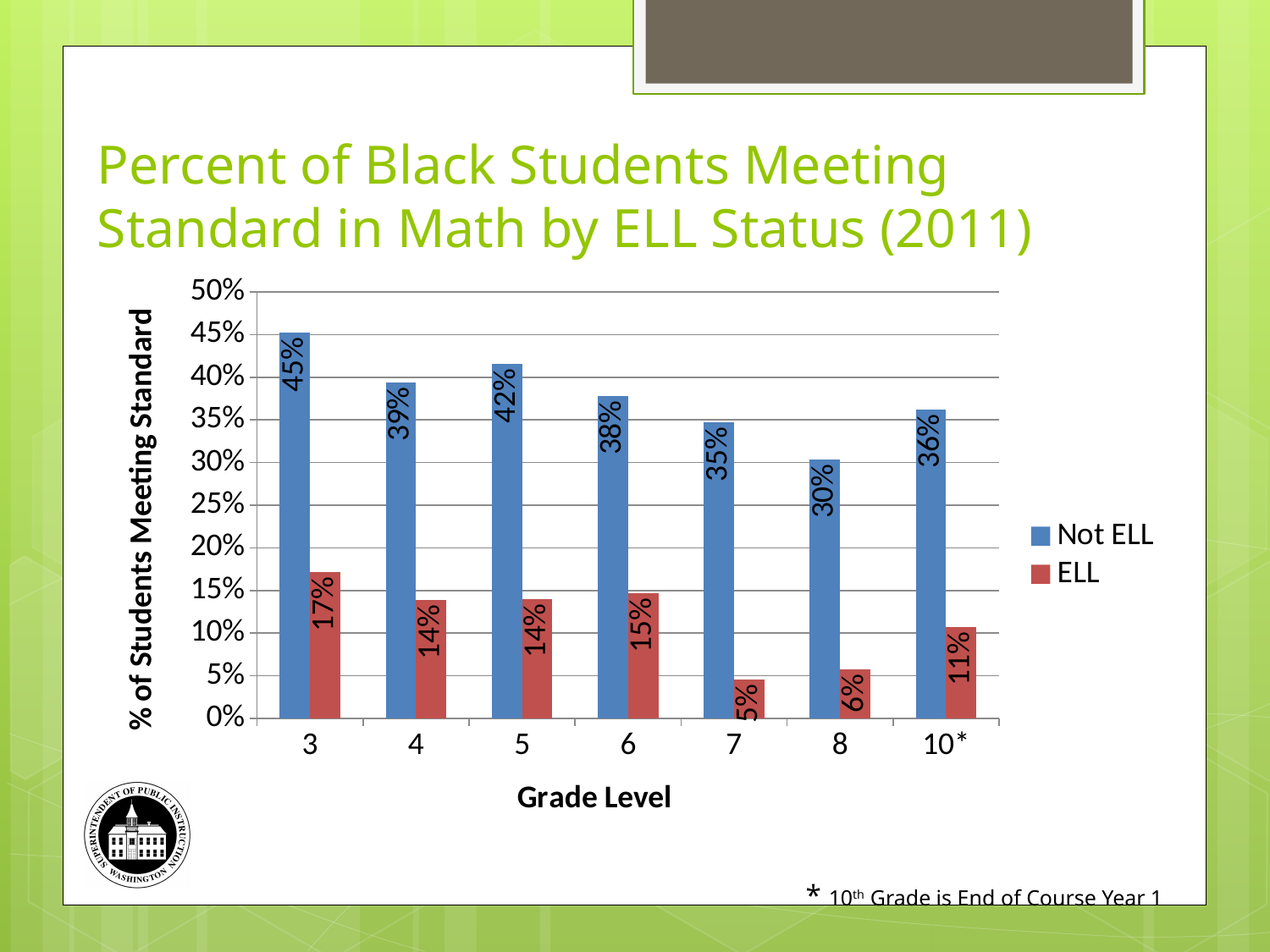
What kind of chart is shown on the slide? Bar chart Which colour represents the ELL series in the legend? Red What is the difference between the Not ELL and ELL values in grade 8? 24% Which grade level has the lowest value for ELL students? 7 How many grade levels are shown on the x axis? 7 What percent of Not ELL Black students met standard in math in grade 3? 45% Which is larger: the Not ELL value in grade 5 or the Not ELL value in grade 6? Not ELL value in grade 5 What is the value for ELL students in grade 10*? 11% Which grade level has the highest value for Not ELL students? 3 What is the label of the y axis? % of Students Meeting Standard What percent of ELL Black students met standard in math in grade 7? 5% How many series does the legend list? 2